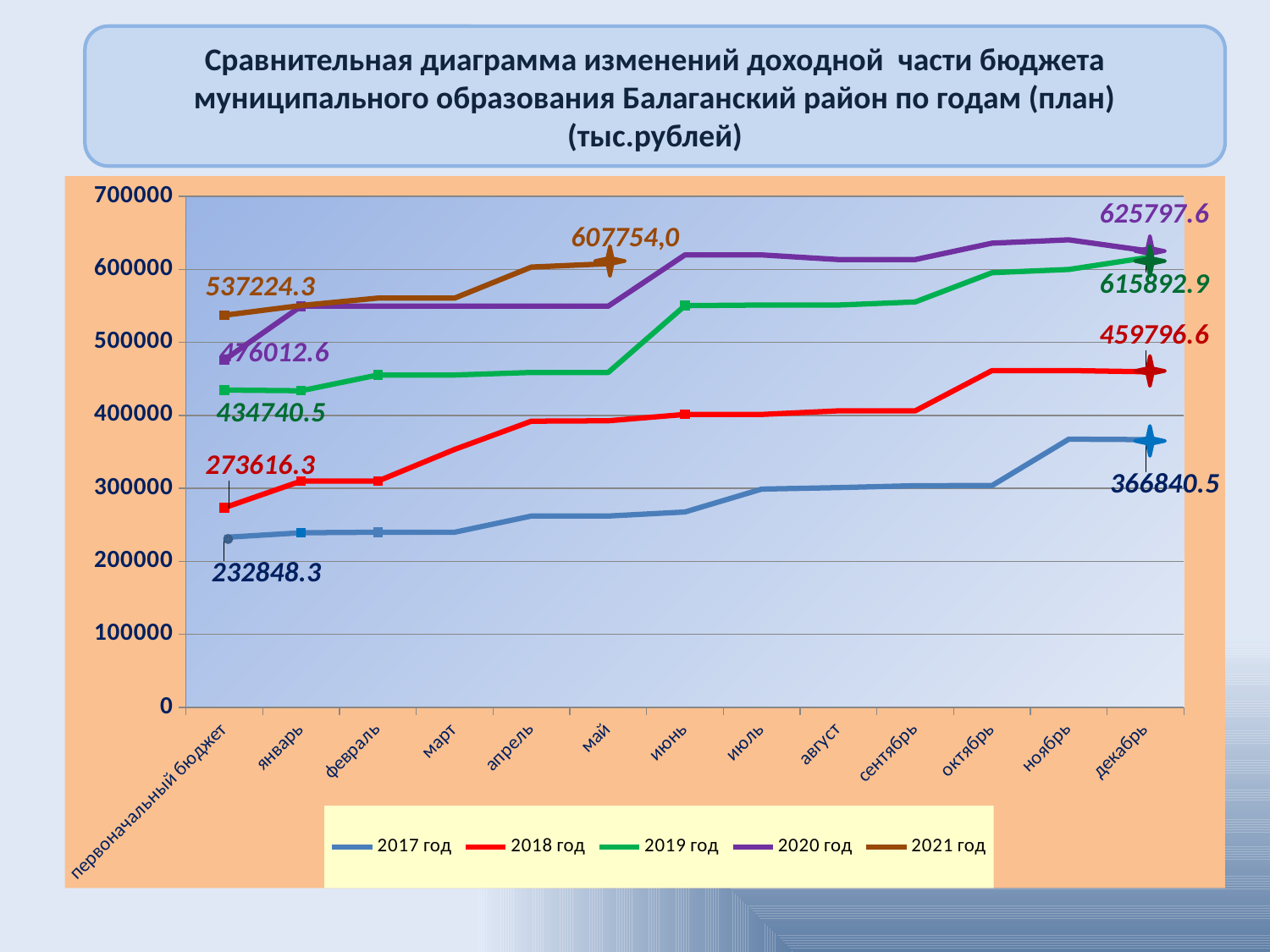
What is the value for 2017 год at первоначальный бюджет? 232848.3 What is the value for 2020 год at первоначальный бюджет? 476012.6 What is the value for 2021 год at май? 607754,0 How many categories are shown along the x axis? 13 What kind of chart is shown on the slide? line chart Which series has the highest value at декабрь? 2020 год What is the difference between the 2018 год values at декабрь and первоначальный бюджет? 186180.3 How many series does the legend list? 5 What is the value for 2018 год at декабрь? 459796.6 Which series has the lowest value at первоначальный бюджет? 2017 год What is the value for 2019 год at декабрь? 615892.9